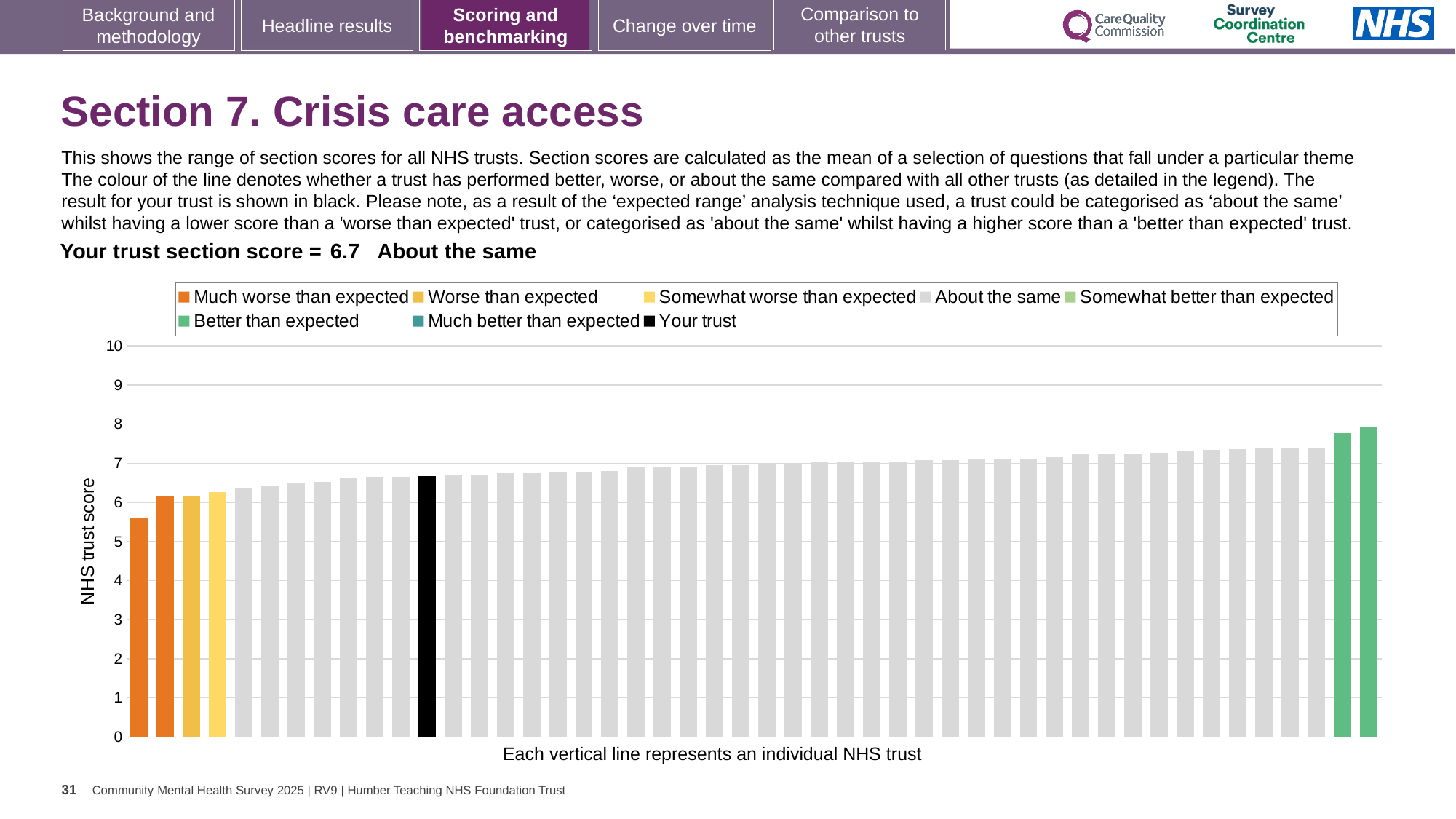
Which category is your trust placed in for Section 7 Crisis care access? About the same Is the value of the rightmost (tallest) bar greater or less than 7? greater Is the value of the black bar (your trust) greater or less than 5? greater What kind of chart is shown on the slide? bar chart Do the bar values rise or fall from left to right along the x axis? rise Which is larger, the value of the black bar or the value of the leftmost orange bar? the black bar How many bars are coloured green (Better than expected)? 2 Is the value of the leftmost (lowest) bar greater or less than 6? less What is the label on the vertical axis of the chart? NHS trust score How many entries does the chart legend list? 8 What is the section score for your trust shown on the slide? 6.7 How many bars are coloured orange (Much worse than expected)? 2